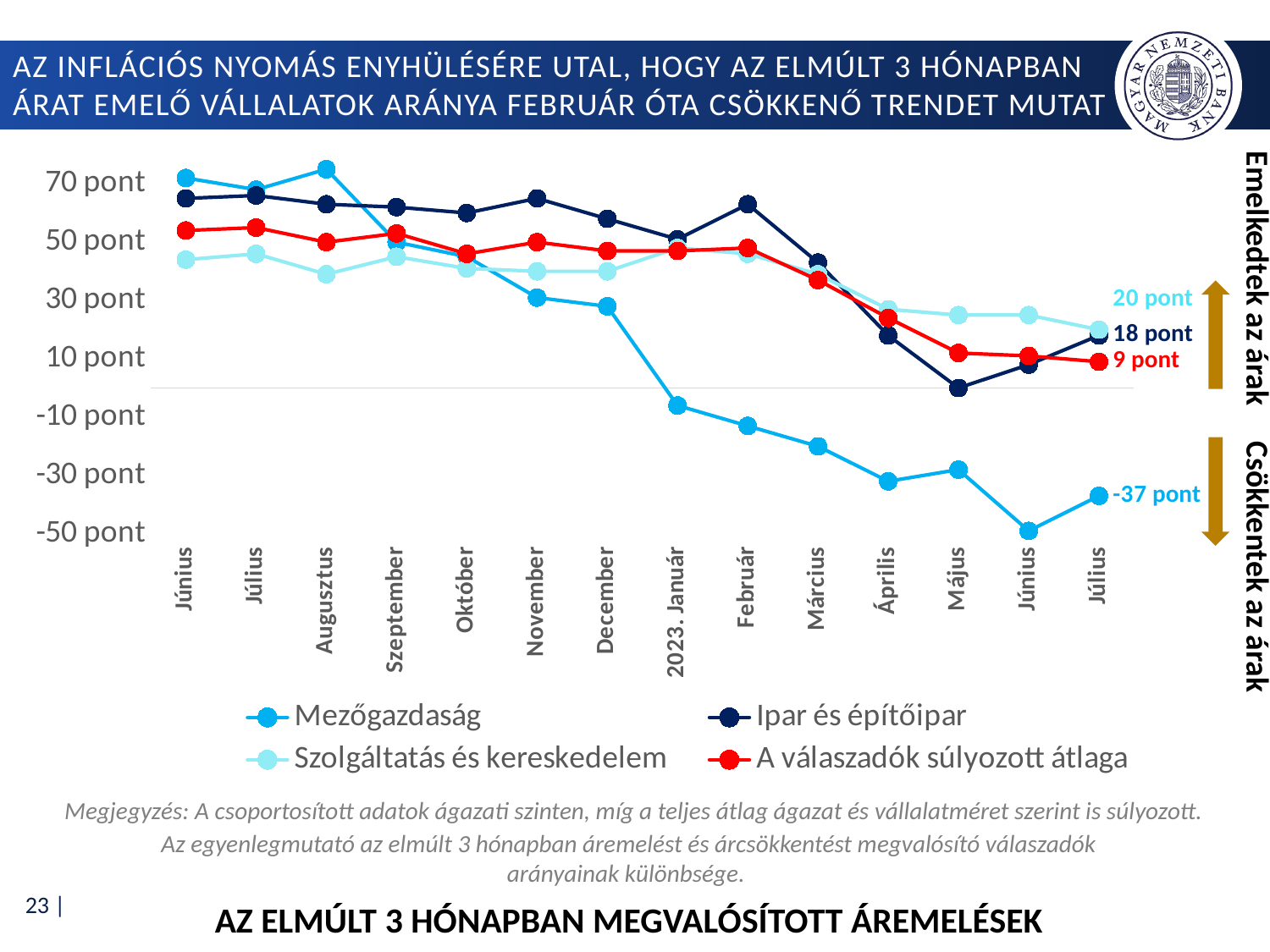
What is the value of the Ipar és építőipar series at the final point (Július 2023)? 18 pont What value does the Mezőgazdaság series reach in Július 2023, the last point on the chart? -37 pont What is the value of A válaszadók súlyozott átlaga at the final point (Július 2023)? 9 pont What is the value of the Szolgáltatás és kereskedelem series at the final point (Július 2023)? 20 pont Is the value for Mezőgazdaság in Június 2023 greater or less than -30 pont? less What kind of chart is shown on the slide? Line chart How many months (data points) are shown along the x axis? 14 Which series has the highest value at the final point (Július 2023)? Szolgáltatás és kereskedelem Which series has the lowest value at the final point (Július 2023)? Mezőgazdaság How many series does the legend list? 4 Does the Mezőgazdaság series rise or fall overall from the first point (Június) to the last point (Július 2023)? Falls What is the difference between the Ipar és építőipar value and A válaszadók súlyozott átlaga value at the final point (Július 2023)? 9 pont